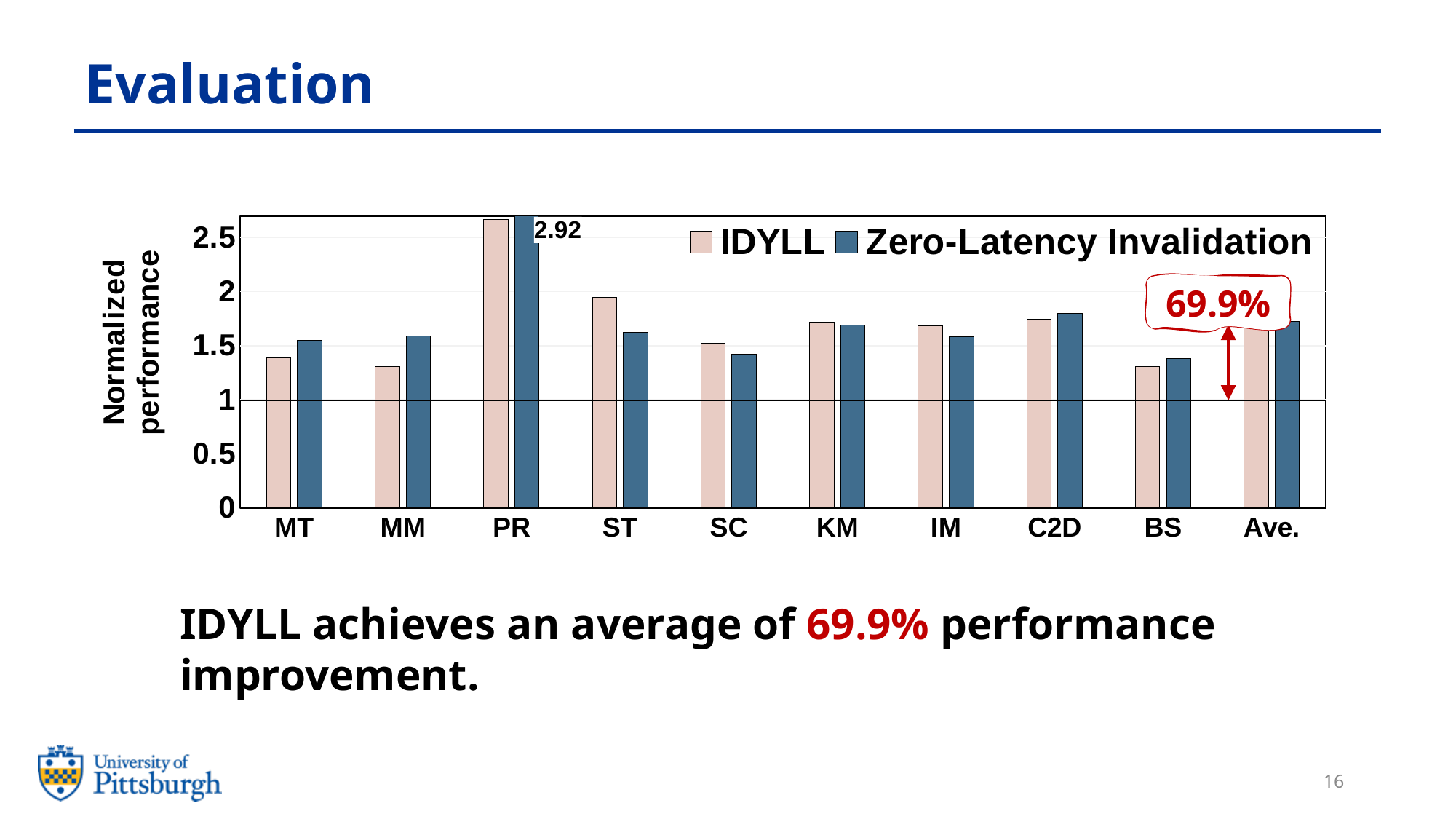
For ST, which series has the larger value, IDYLL or Zero-Latency Invalidation? IDYLL How many categories are shown along the x axis of the chart? 10 What value is printed as a data label next to the PR bars? 2.92 Is the Zero-Latency Invalidation value for C2D greater or less than 1.5? greater Which category has the highest Zero-Latency Invalidation value? PR What kind of chart is shown on the slide? bar chart Which category has the highest IDYLL value? PR How many series does the chart legend list? 2 Is the IDYLL value for MT greater or less than 1.5? less What is the label on the y axis of the chart? Normalized performance For MM, which series has the larger value, IDYLL or Zero-Latency Invalidation? Zero-Latency Invalidation